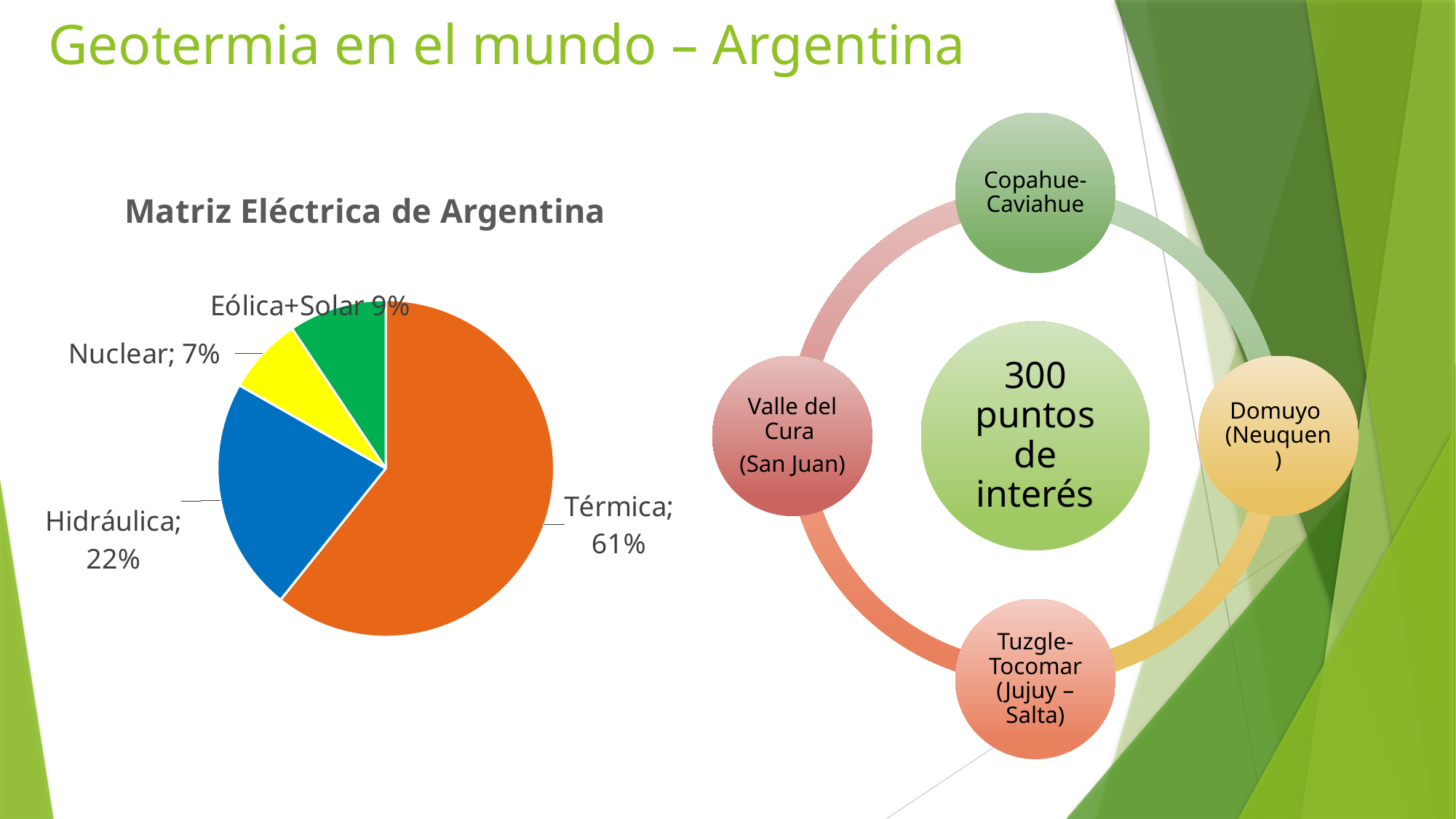
What is the title of the pie chart? Matriz Eléctrica de Argentina Which category has the largest slice of the pie? Térmica What is the difference in percentage points between Térmica and Hidráulica? 39 Which is larger, Eólica+Solar or Nuclear? Eólica+Solar What share of the pie does Nuclear represent? 7% What share of the pie does Eólica+Solar represent? 9% What colour is the Hidráulica slice? blue What share of the pie does Térmica represent? 61% Which category has the smallest slice of the pie? Nuclear What type of chart is "Matriz Eléctrica de Argentina"? pie chart How many categories are shown in the pie chart? 4 What share of the pie does Hidráulica represent? 22%